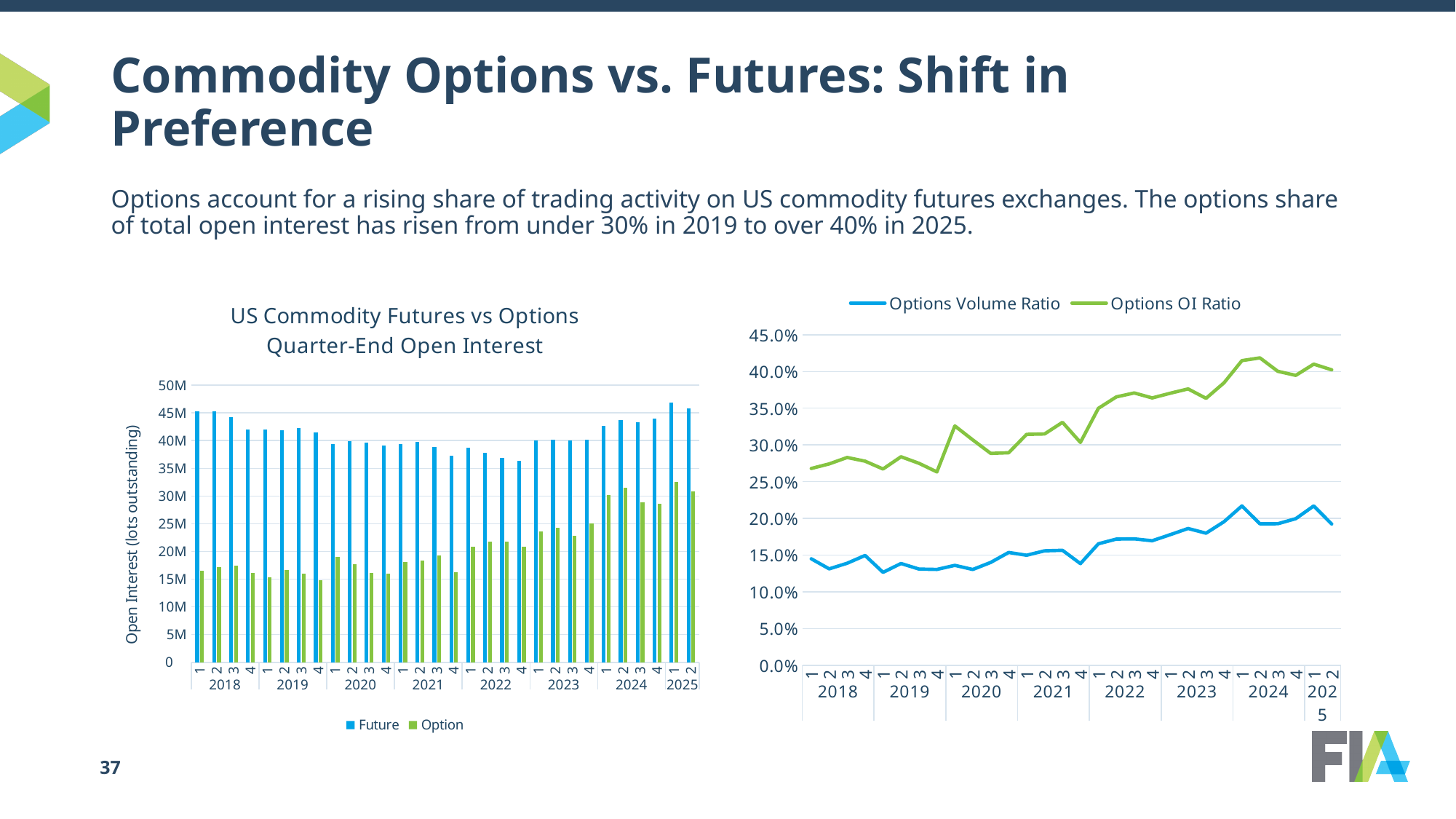
In the right-hand line chart, is the Options OI Ratio for quarter 1 of 2018 greater or less than 30.0%? less In the right-hand line chart, how many series does the legend list? 2 What kind of chart is the chart on the right showing Options Volume Ratio and Options OI Ratio? line chart In the 'US Commodity Futures vs Options Quarter-End Open Interest' chart, is the Option value for quarter 1 of 2018 greater or less than 20M? less In the 'US Commodity Futures vs Options Quarter-End Open Interest' chart, how many series does the legend list? 2 In the right-hand line chart, is the Options Volume Ratio for quarter 1 of 2024 greater or less than 20.0%? greater In the 'US Commodity Futures vs Options Quarter-End Open Interest' chart, which is larger in quarter 2 of 2025, Future or Option? Future What kind of chart is the 'US Commodity Futures vs Options Quarter-End Open Interest' chart on the left? bar chart What is the y-axis label of the 'US Commodity Futures vs Options Quarter-End Open Interest' chart? Open Interest (lots outstanding) In the right-hand line chart, does the Options OI Ratio generally rise or fall from 2018 to 2025? rise In the 'US Commodity Futures vs Options Quarter-End Open Interest' chart, which quarter has the highest Future bar? 2025 quarter 1